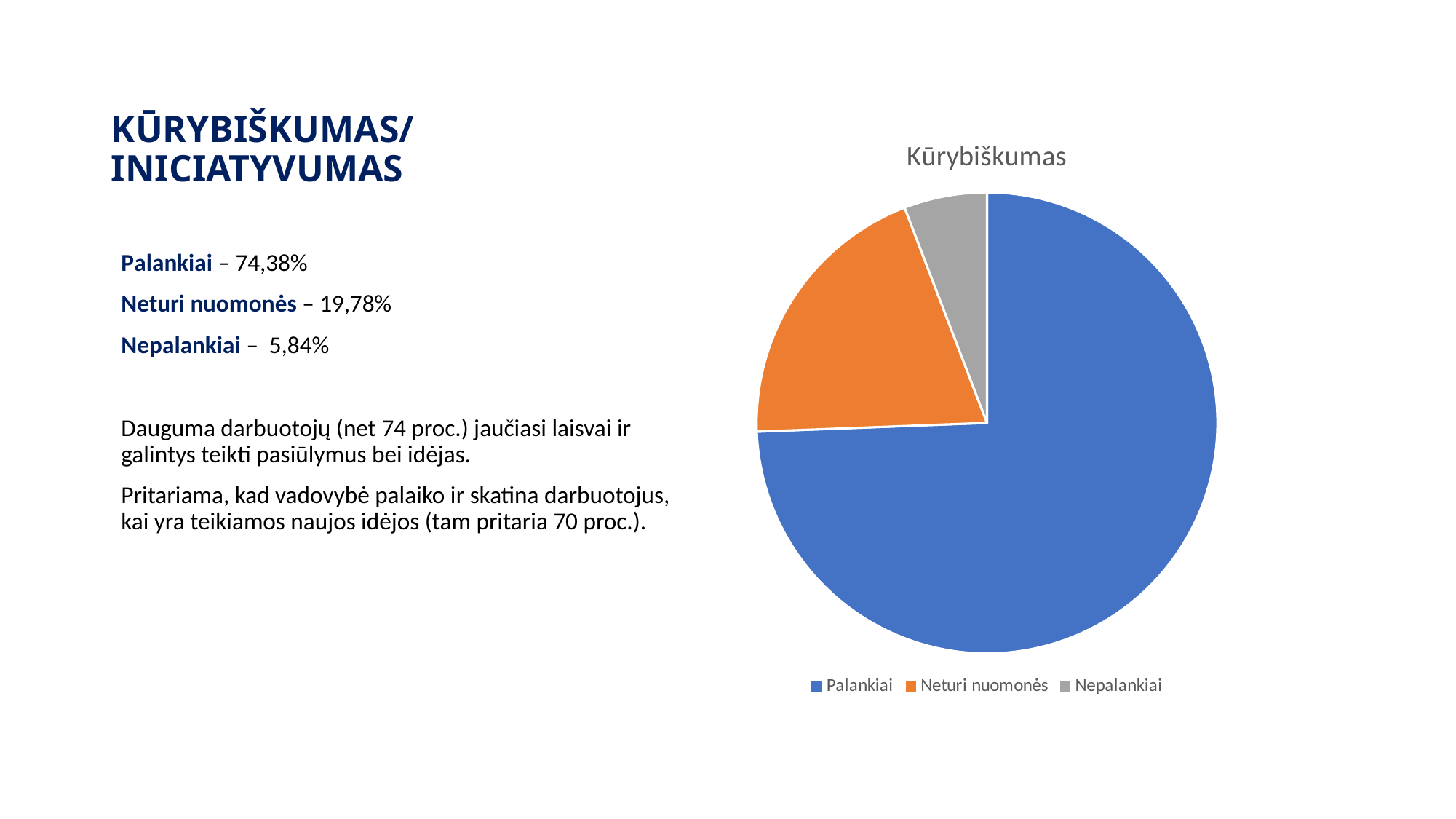
What is the title of the chart? Kūrybiškumas What share of the pie does Nepalankiai take? 5,84% What share of the pie does Neturi nuomonės take? 19,78% Which is larger, the slice for Neturi nuomonės or the slice for Nepalankiai? Neturi nuomonės What kind of chart is shown on the slide? pie chart Which colour represents Neturi nuomonės in the pie chart? orange Which category has the smallest slice of the pie? Nepalankiai What is the difference between the Palankiai share and the Neturi nuomonės share? 54,60% How many slices does the pie chart have? 3 Which category has the largest slice of the pie? Palankiai How many entries does the chart legend list? 3 What share of the pie does Palankiai take? 74,38%